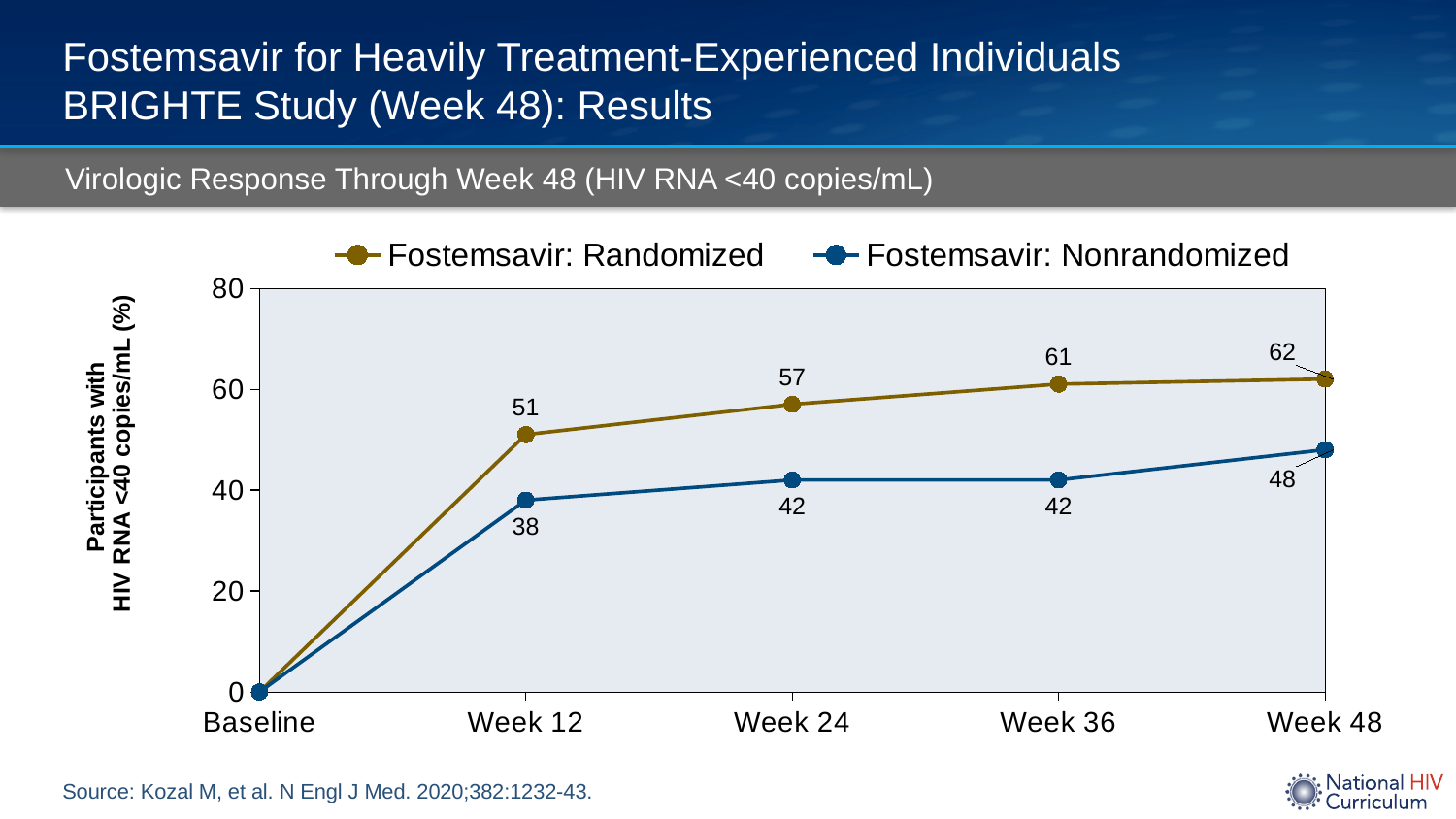
How many series does the legend list? 2 Which series has the larger value at Week 36, Fostemsavir: Randomized or Fostemsavir: Nonrandomized? Fostemsavir: Randomized What is the difference between the Fostemsavir: Randomized and Fostemsavir: Nonrandomized values at Week 24? 15 What kind of chart is shown on the slide? Line chart Is the value for Fostemsavir: Nonrandomized at Week 12 greater or less than 40? less At which time point is the Fostemsavir: Randomized series highest? Week 48 How many time points are shown on the x axis? 5 What is the value for Fostemsavir: Nonrandomized at Week 36? 42 What is the value for Fostemsavir: Randomized at Week 12? 51 What is the value for Fostemsavir: Nonrandomized at Week 48? 48 What is the difference between the Fostemsavir: Randomized values at Week 48 and Week 12? 11 Does the Fostemsavir: Randomized series rise or fall from Baseline to Week 48? Rise